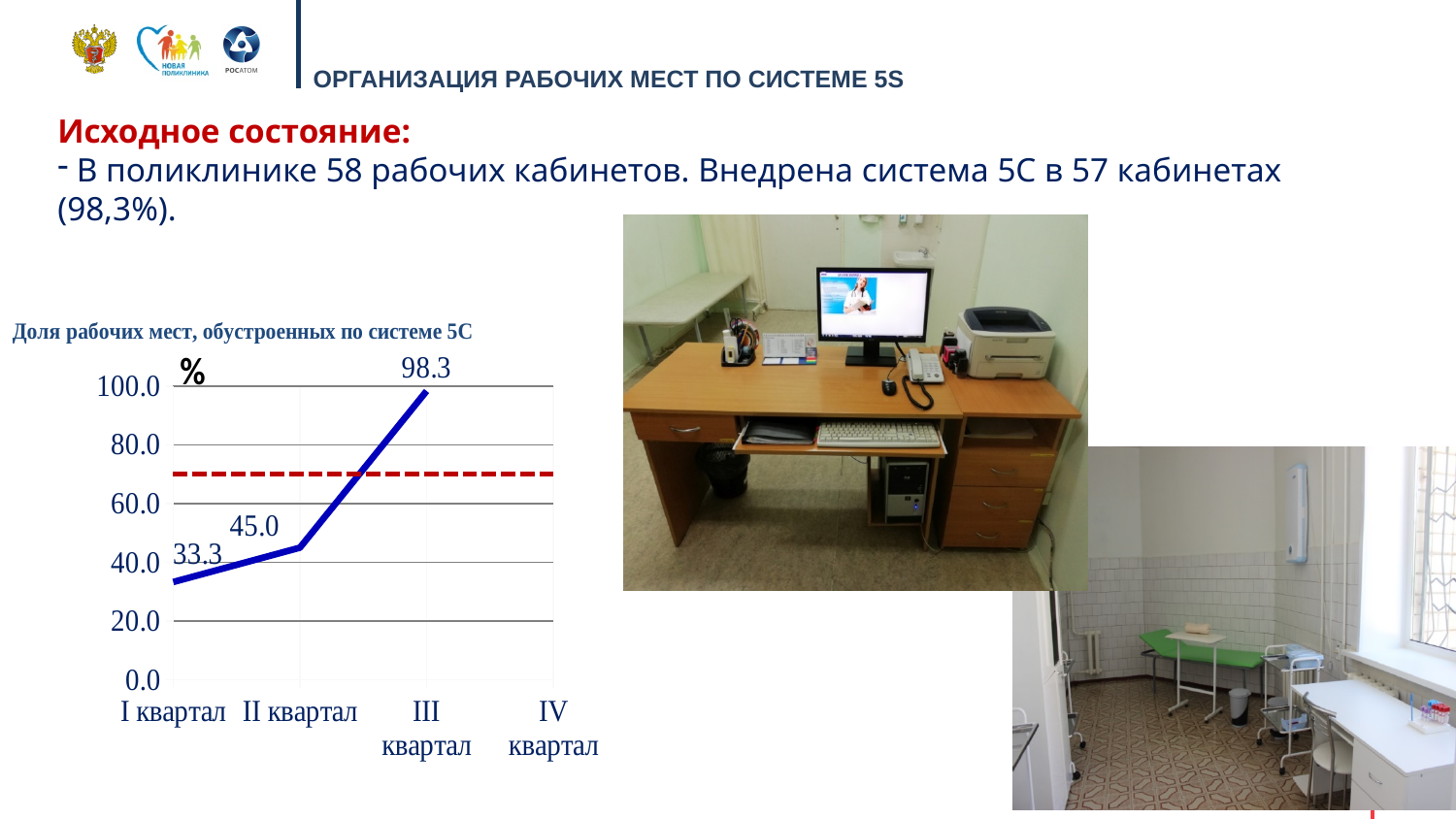
What is the difference between the values for III квартал and I квартал? 65.0 Which quarter has the highest value in the chart? III квартал Is the value for I квартал greater or less than 40.0? less What is the title of the chart on the slide? Доля рабочих мест, обустроенных по системе 5С What is the value for III квартал in the chart? 98.3 What kind of chart is shown on the slide? line chart What is the value for II квартал in the chart? 45.0 Which quarter has the lowest plotted value in the chart? I квартал Do the plotted values rise or fall from I квартал to III квартал? rise What is the value for I квартал in the chart 'Доля рабочих мест, обустроенных по системе 5С'? 33.3 What is the difference between the values for II квартал and I квартал? 11.7 Which is larger, the value for II квартал or the value for III квартал? III квартал